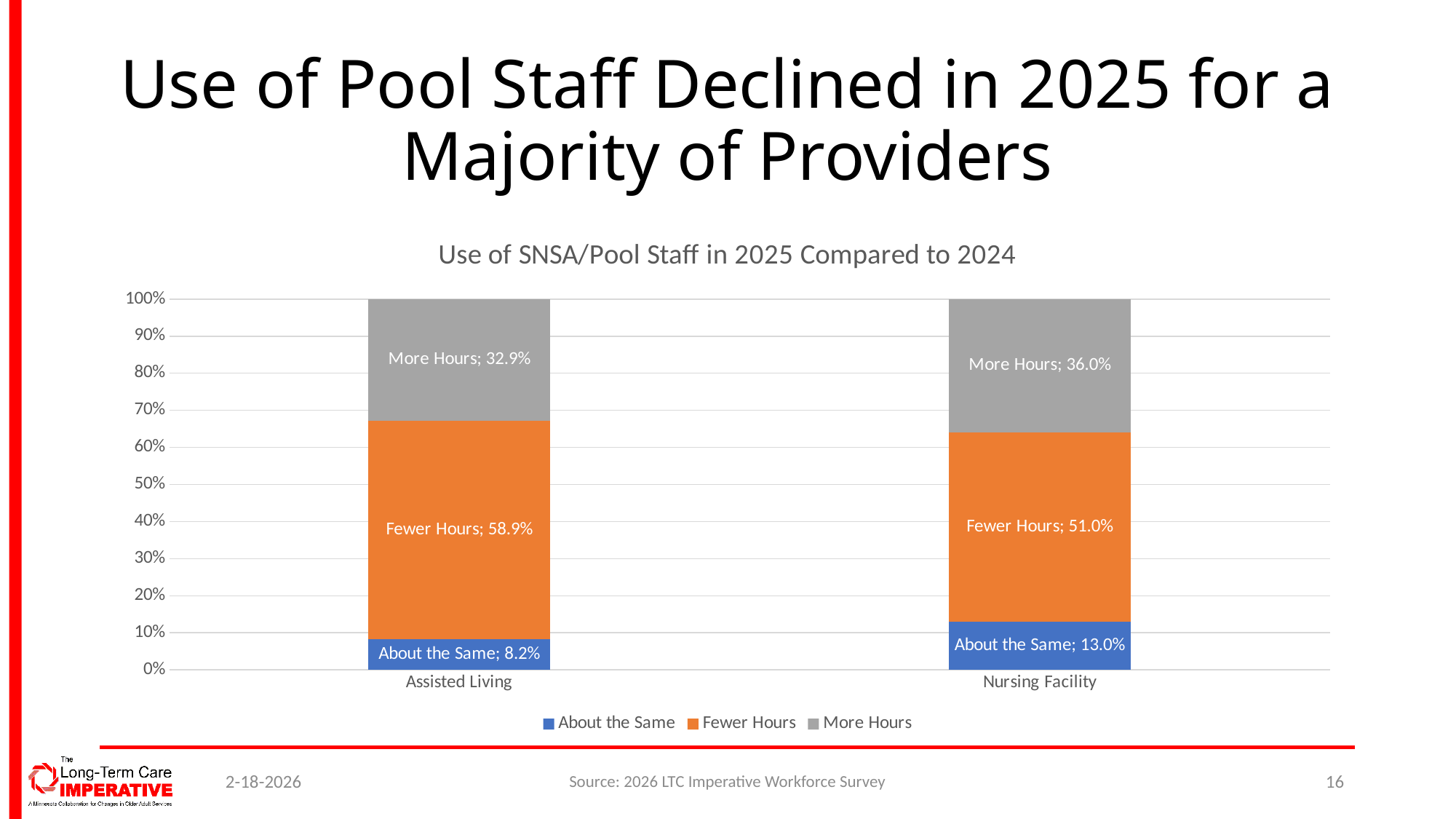
How many provider categories are shown on the x axis? 2 What percentage of Nursing Facility providers reported About the Same use of SNSA/Pool Staff? 13.0% Which provider type has the larger More Hours share, Assisted Living or Nursing Facility? Nursing Facility What is the difference between the Fewer Hours values for Assisted Living and Nursing Facility? 7.9% What percentage of Assisted Living providers reported Fewer Hours of SNSA/Pool Staff use in 2025 compared to 2024? 58.9% Which segment is the smallest in the Nursing Facility bar? About the Same What kind of chart is shown on the slide? Stacked bar chart What is the About the Same value for Assisted Living? 8.2% How many series does the legend list? 3 What is the More Hours value for Nursing Facility? 36.0% What is the title of the chart? Use of SNSA/Pool Staff in 2025 Compared to 2024 Which segment is the largest in the Assisted Living bar? Fewer Hours